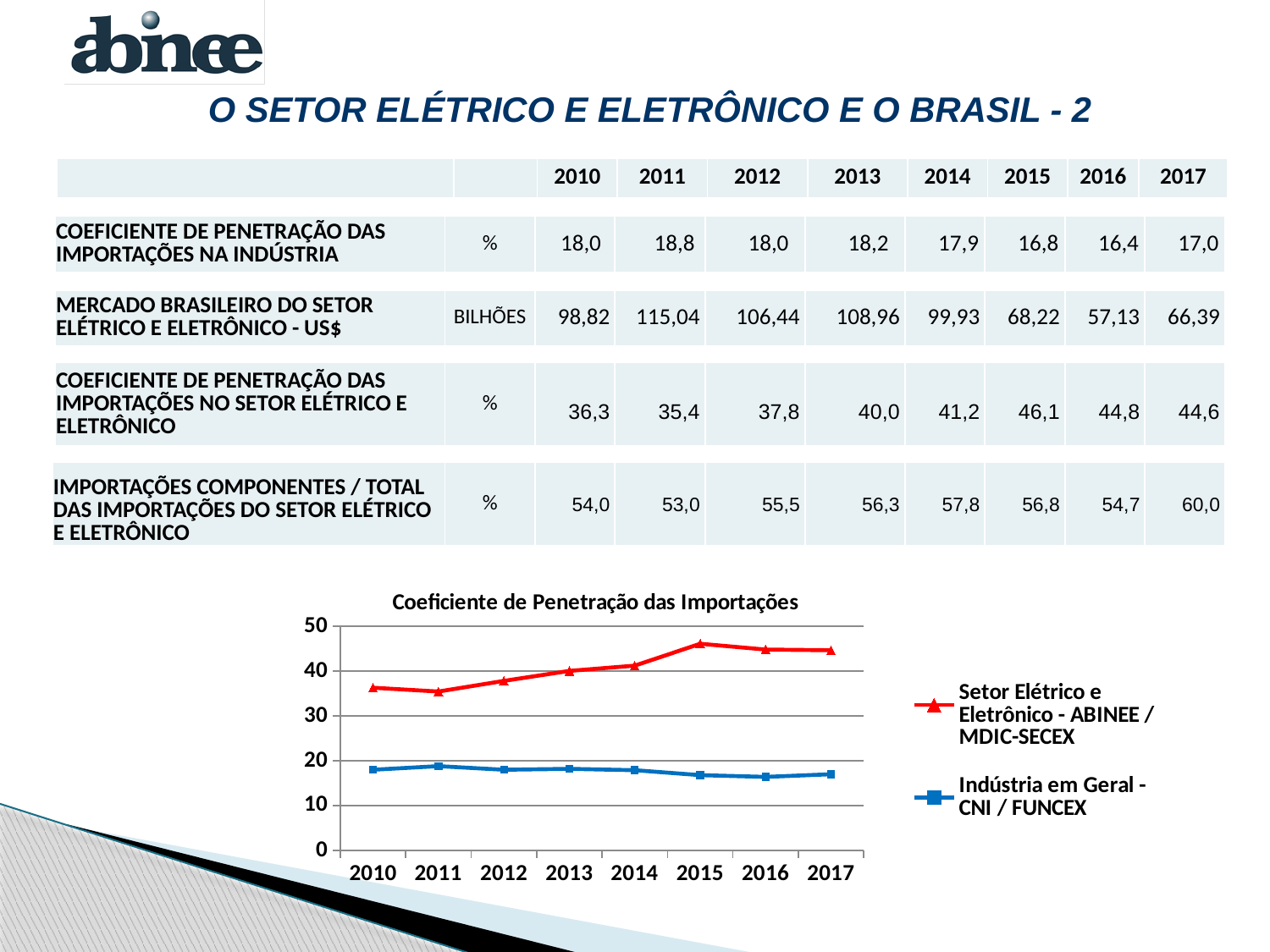
Does the 'Setor Elétrico e Eletrônico - ABINEE / MDIC-SECEX' series rise or fall from 2010 to 2015? rise In which year does the 'Setor Elétrico e Eletrônico - ABINEE / MDIC-SECEX' series reach its highest value? 2015 How many series does the chart legend list? 2 Is the 2010 value for 'Setor Elétrico e Eletrônico - ABINEE / MDIC-SECEX' greater or less than 40? less How many years are plotted along the x axis of the chart? 8 What type of chart is shown on the slide? line chart In 2017, which series has the larger value: 'Setor Elétrico e Eletrônico - ABINEE / MDIC-SECEX' or 'Indústria em Geral - CNI / FUNCEX'? Setor Elétrico e Eletrônico - ABINEE / MDIC-SECEX What is the title of the chart? Coeficiente de Penetração das Importações Is the 2015 value for 'Setor Elétrico e Eletrônico - ABINEE / MDIC-SECEX' greater or less than 40? greater Which colour is used for the 'Indústria em Geral - CNI / FUNCEX' series in the chart? blue Does the 'Indústria em Geral - CNI / FUNCEX' series stay above or below 30 across all years? below